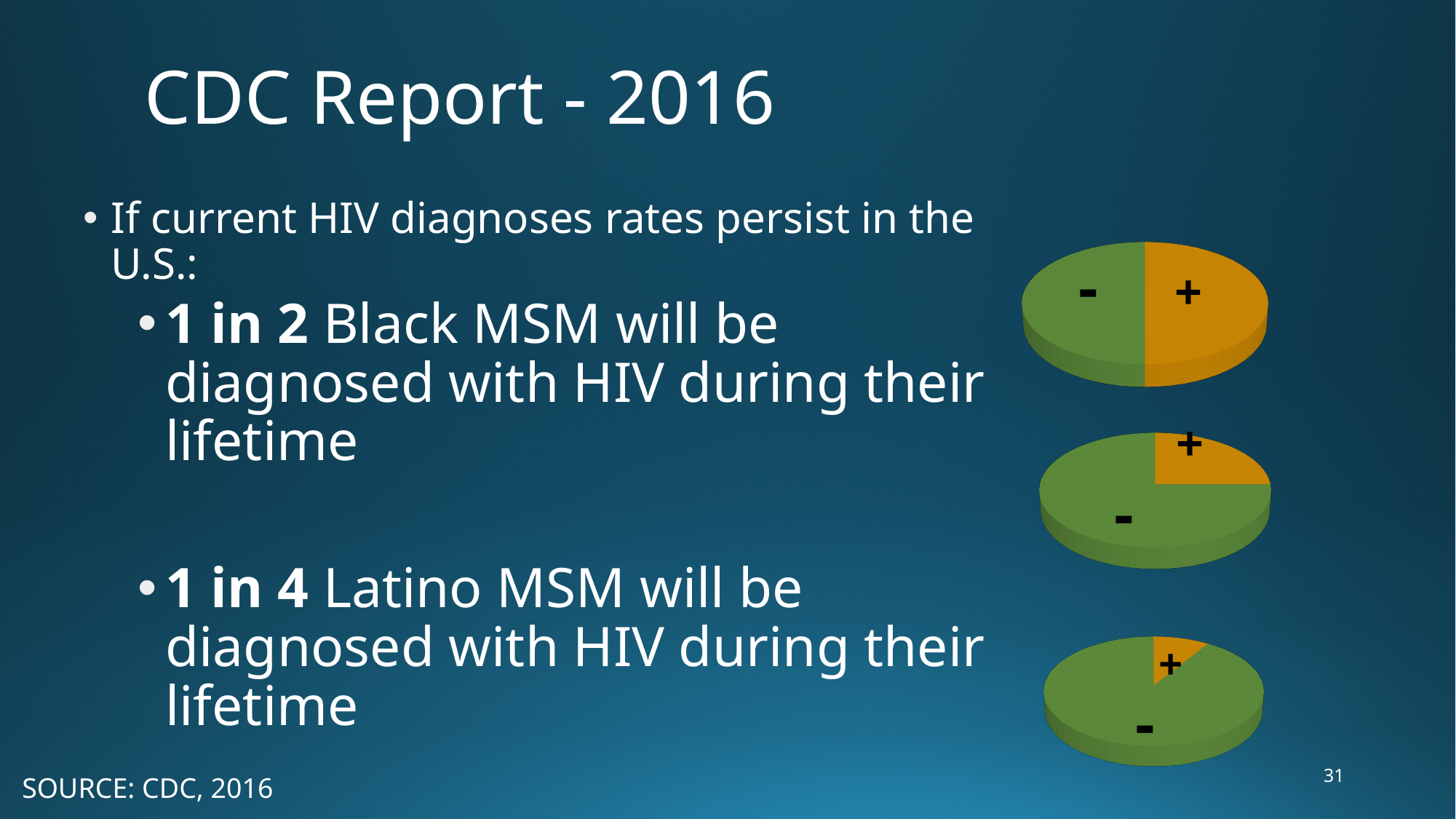
How many slices does the top pie chart have? 2 Going from the top pie chart to the bottom pie chart, does the "+" slice get larger or smaller? Smaller How many pie charts are shown on the slide? 3 Which of the three pie charts has the smallest "+" slice? The bottom pie chart In the middle pie chart, is the "+" slice greater or less than half of the pie? less What kind of chart is the top chart on the right of the slide? Pie chart What colour is the "+" slice in each pie chart? Orange What colour is the "-" slice in each pie chart? Green Which of the three pie charts has the largest "+" slice? The top pie chart In the bottom pie chart, which slice is larger, the "+" slice or the "-" slice? - In the middle pie chart, which slice is larger, the "+" slice or the "-" slice? -